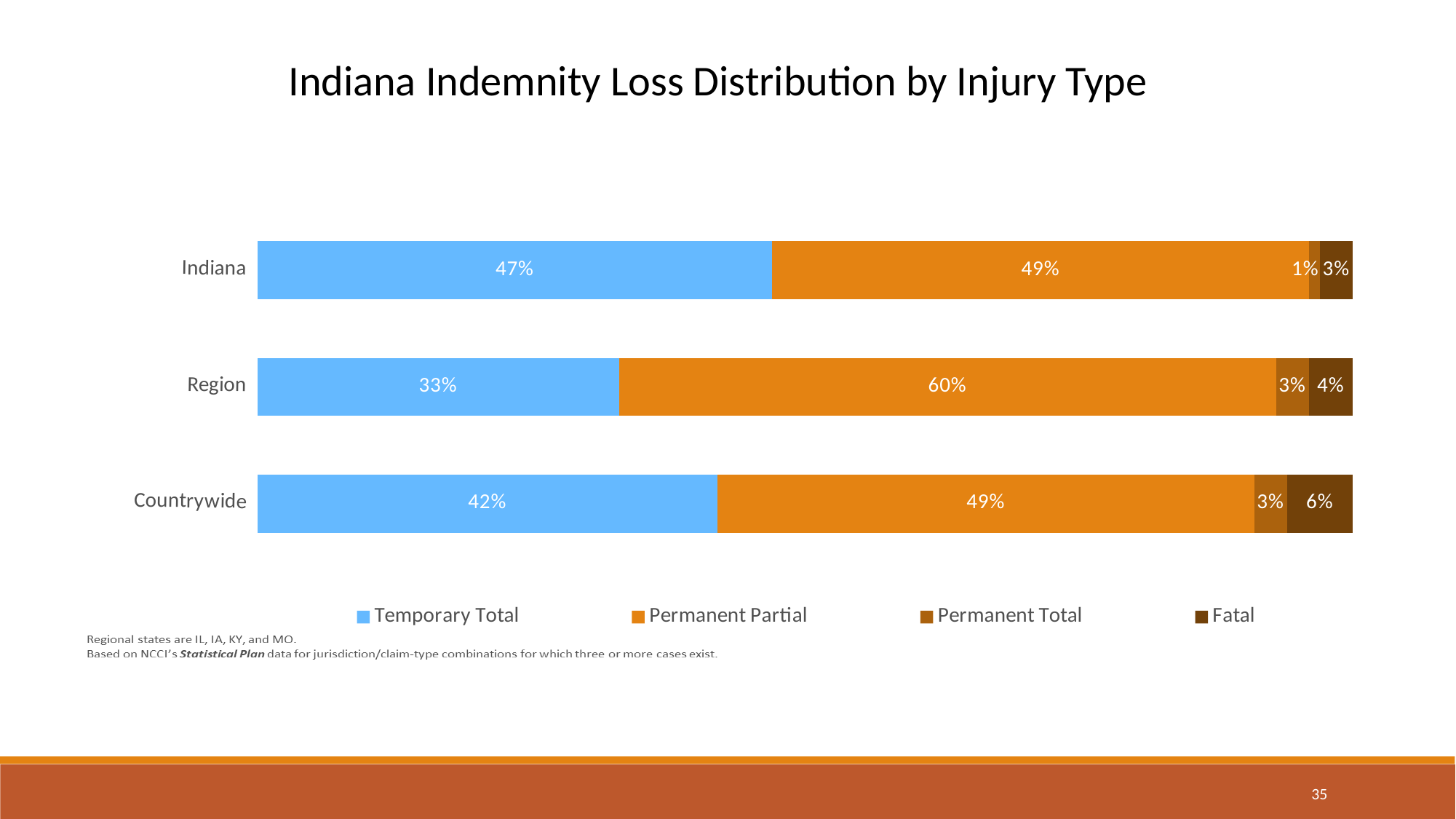
What is the Permanent Partial share for Region? 60% Which category has the highest Temporary Total share? Indiana What is the title of the chart? Indiana Indemnity Loss Distribution by Injury Type How many series does the legend list? 4 Which is larger, the Permanent Partial share for Region or for Countrywide? Region How many categories are shown on the chart? 3 What kind of chart is shown on the slide? Stacked bar chart What is the Fatal share for Countrywide? 6% What is the Permanent Total share for Indiana? 1% What is the Temporary Total share for Indiana? 47% What is the difference between the Temporary Total shares for Indiana and Region? 14% Which category has the lowest Fatal share? Indiana